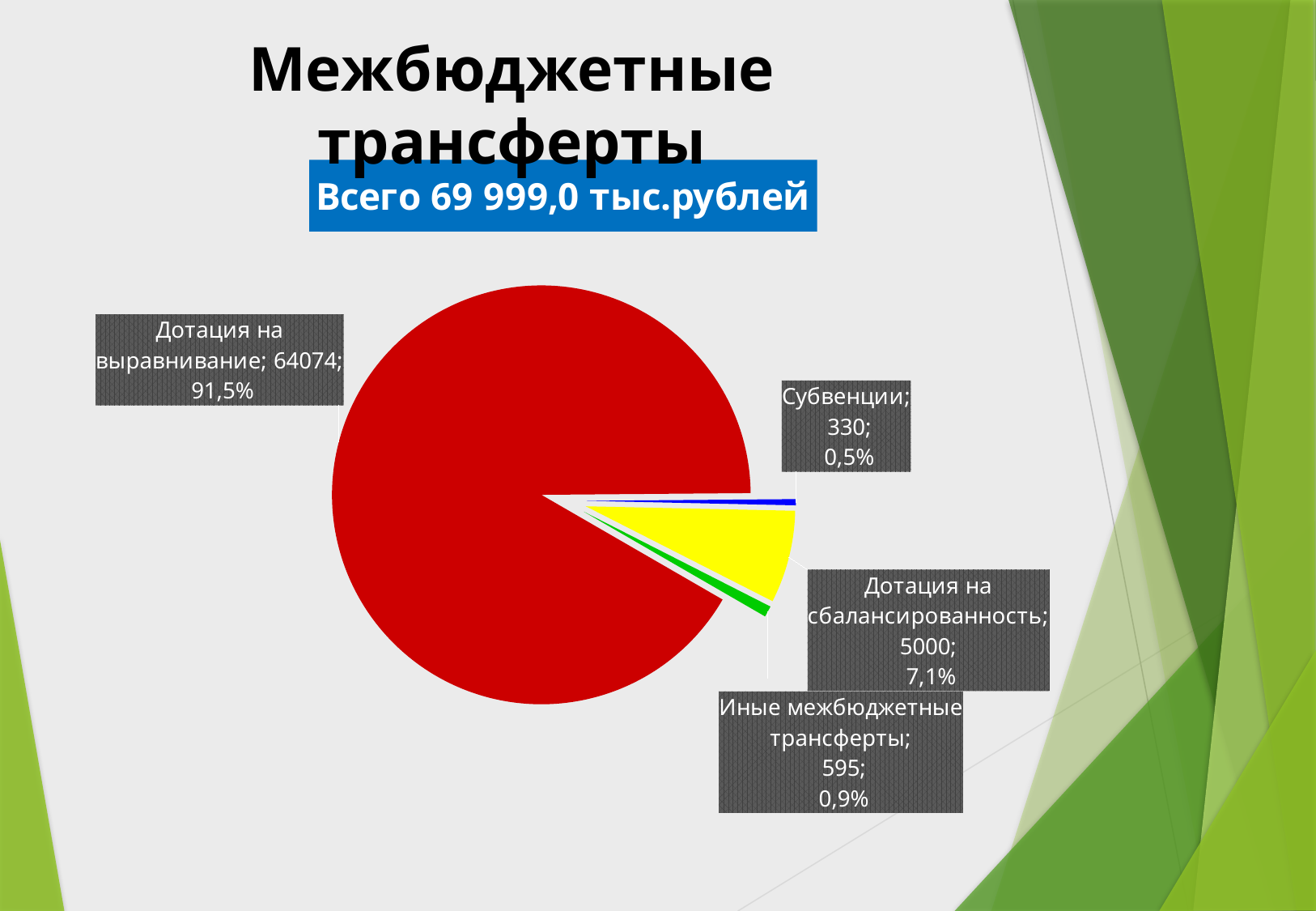
What type of chart is shown on the slide? Pie chart What is the difference between the values for Дотация на сбалансированность and Иные межбюджетные трансферты? 4405 What share of the pie does Дотация на сбалансированность represent? 7,1% Which category has the smallest slice of the pie? Субвенции What is the value for Дотация на сбалансированность? 5000 How many slices does the pie chart have? 4 What is the value for Дотация на выравнивание? 64074 Which category has the largest slice of the pie? Дотация на выравнивание Which is larger, the value for Субвенции or the value for Иные межбюджетные трансферты? Иные межбюджетные трансферты What is the value for Иные межбюджетные трансферты? 595 What share of the pie does Иные межбюджетные трансферты represent? 0,9% What is the value for Субвенции? 330